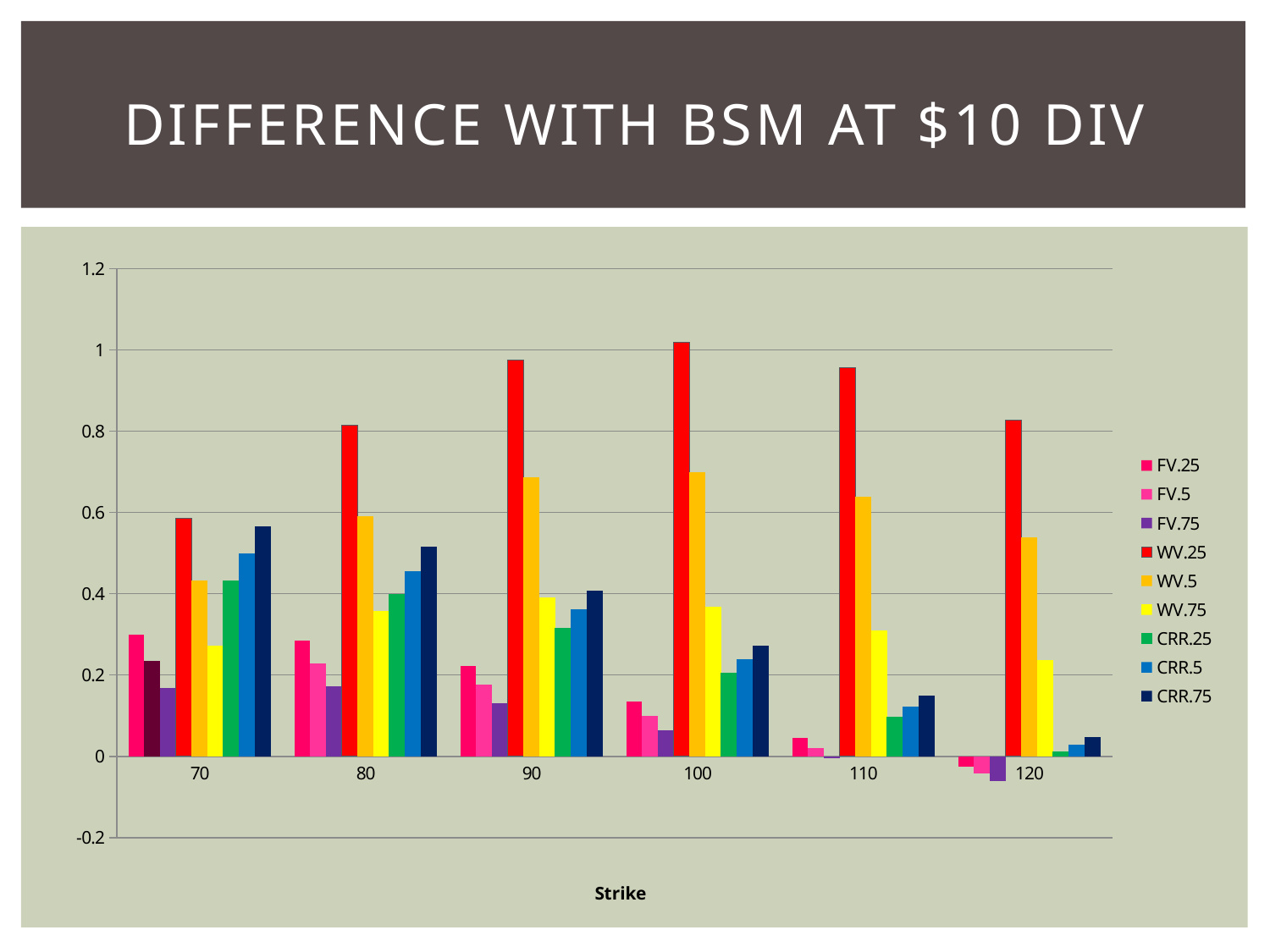
How many strike categories are shown on the x axis? 6 At which strike is the CRR.25 value lowest? 120 At which strike is the WV.25 value highest? 100 At strike 90, which is larger, WV.25 or WV.5? WV.25 How many series does the legend list? 9 Is the FV.75 value at strike 120 greater or less than 0? less At which strike is the CRR.75 value highest? 70 Do the FV.25 values rise or fall as the strike increases from 70 to 120? fall Is the FV.25 value at strike 70 greater or less than 0.2? greater What is the title of the x axis? Strike Is the WV.25 value at strike 100 greater or less than 1? greater What kind of chart is shown on the slide? bar chart